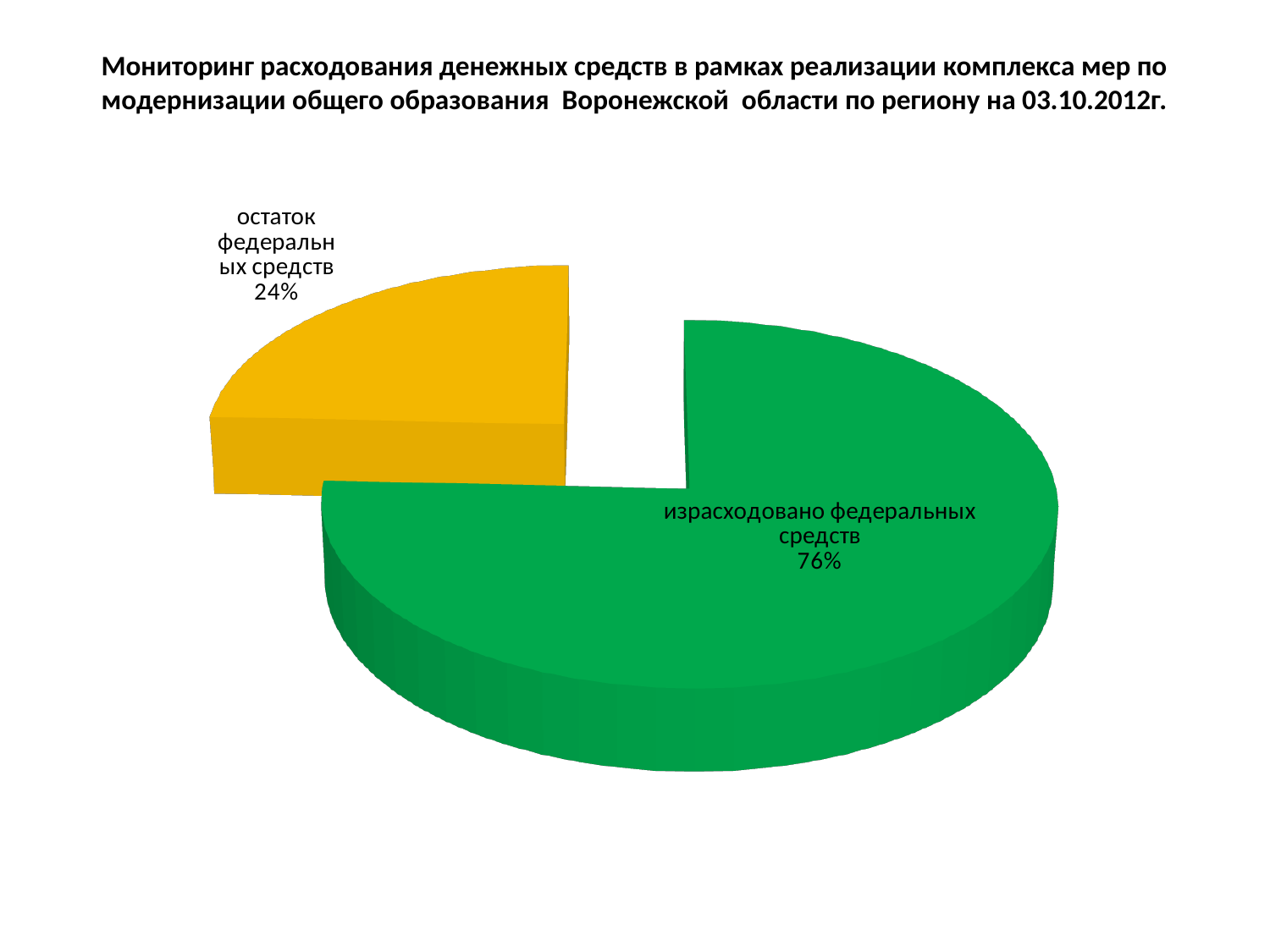
What share of the pie is "остаток федеральных средств"? 24% Which is larger: "остаток федеральных средств" or "израсходовано федеральных средств"? израсходовано федеральных средств How many slices does the pie chart have? 2 What kind of chart is shown on the slide? pie chart What is the difference in percentage points between "израсходовано федеральных средств" and "остаток федеральных средств"? 52 What share of the pie is "израсходовано федеральных средств"? 76% Which slice is the smallest in the pie chart? остаток федеральных средств Which slice is the largest in the pie chart? израсходовано федеральных средств What colour is the slice for "израсходовано федеральных средств"? green What colour is the slice for "остаток федеральных средств"? yellow